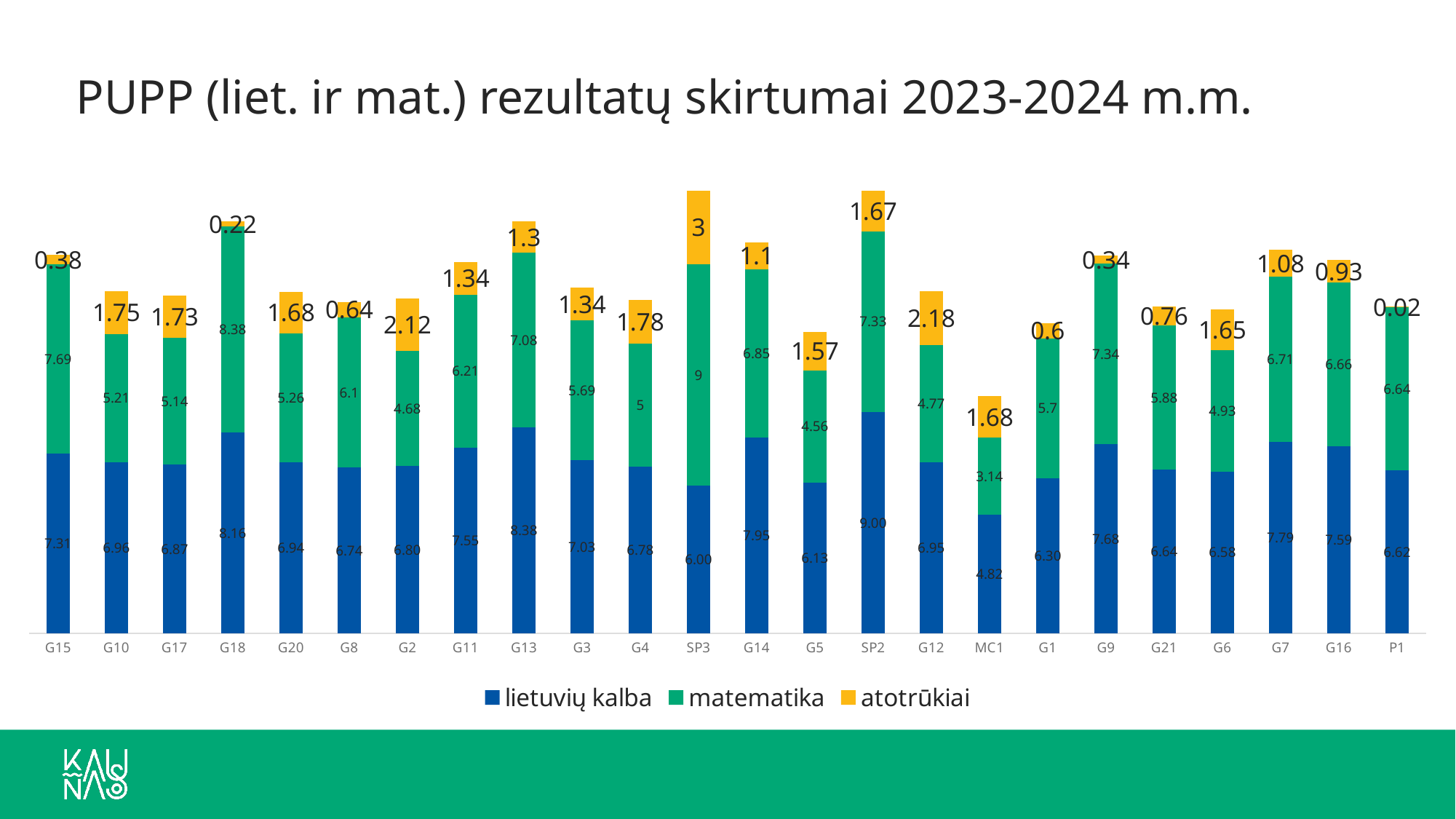
What is the difference between the lietuvių kalba values for SP2 and MC1? 4.18 Which category has the highest atotrūkiai value? SP3 Which category has the highest lietuvių kalba value? SP2 What is the lietuvių kalba value for G13? 8.38 How many series does the legend list? 3 What is the atotrūkiai value for G12? 2.18 Which has the larger lietuvių kalba value, G13 or G14? G13 How many categories are shown on the x axis? 24 What is the matematika value for SP3? 9 Which category has the lowest atotrūkiai value? P1 What is the total of the stacked bar for MC1? 9.64 What is the matematika value for MC1? 3.14